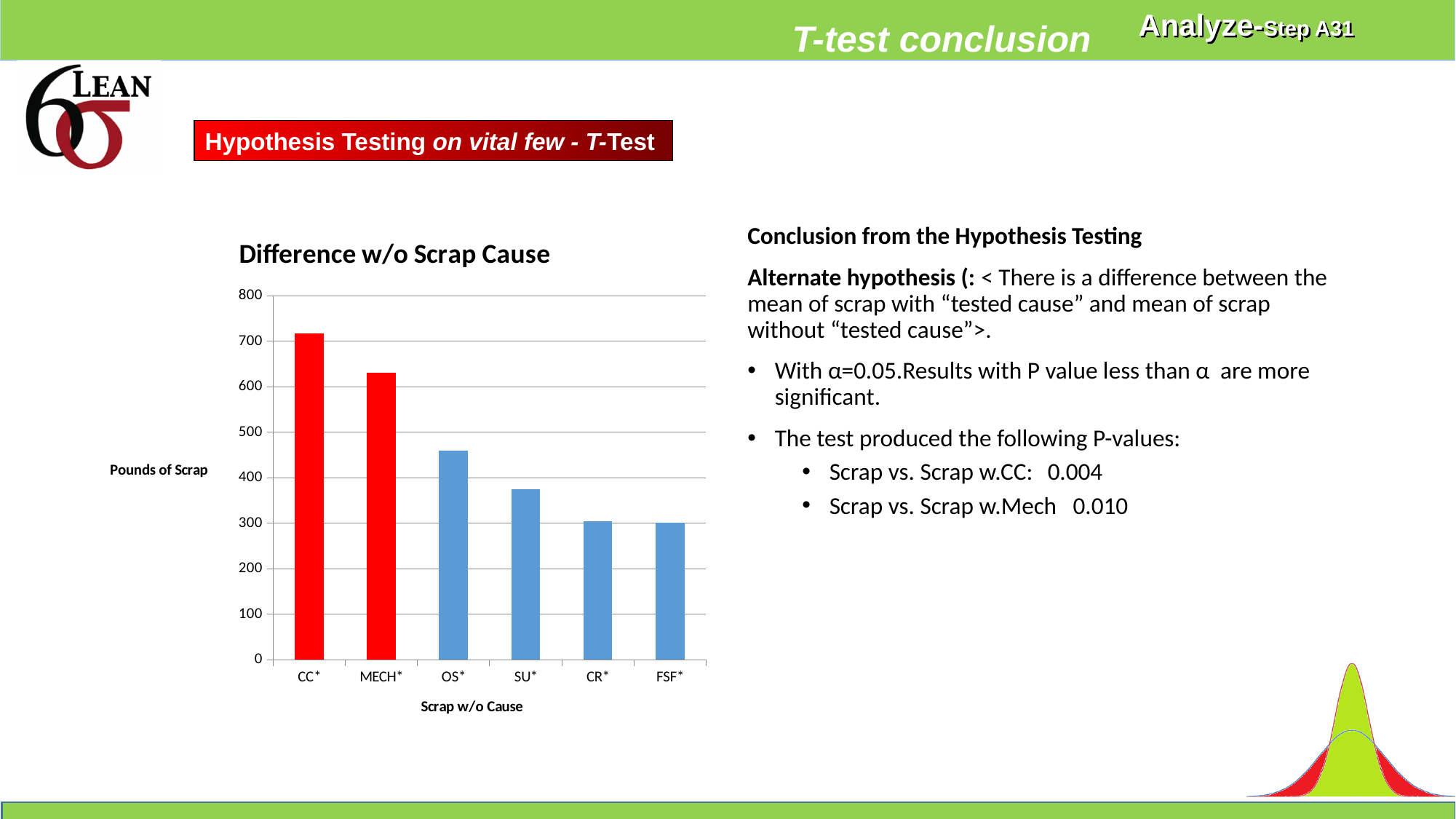
Is the value for CR* greater or less than 400? less What is the label on the vertical axis of the chart? Pounds of Scrap Which categories are shown with red bars in the chart? CC* and MECH* What kind of chart is shown under the title "Difference w/o Scrap Cause"? bar chart Is the value for SU* greater or less than 400? less Which is larger, the value for MECH* or the value for OS*? MECH* Is the value for MECH* greater or less than 600? greater How many categories are plotted on the x axis of the "Difference w/o Scrap Cause" chart? 6 Do the bar values generally rise or fall moving left to right along the x axis? fall Which category has the highest value in the "Difference w/o Scrap Cause" chart? CC*